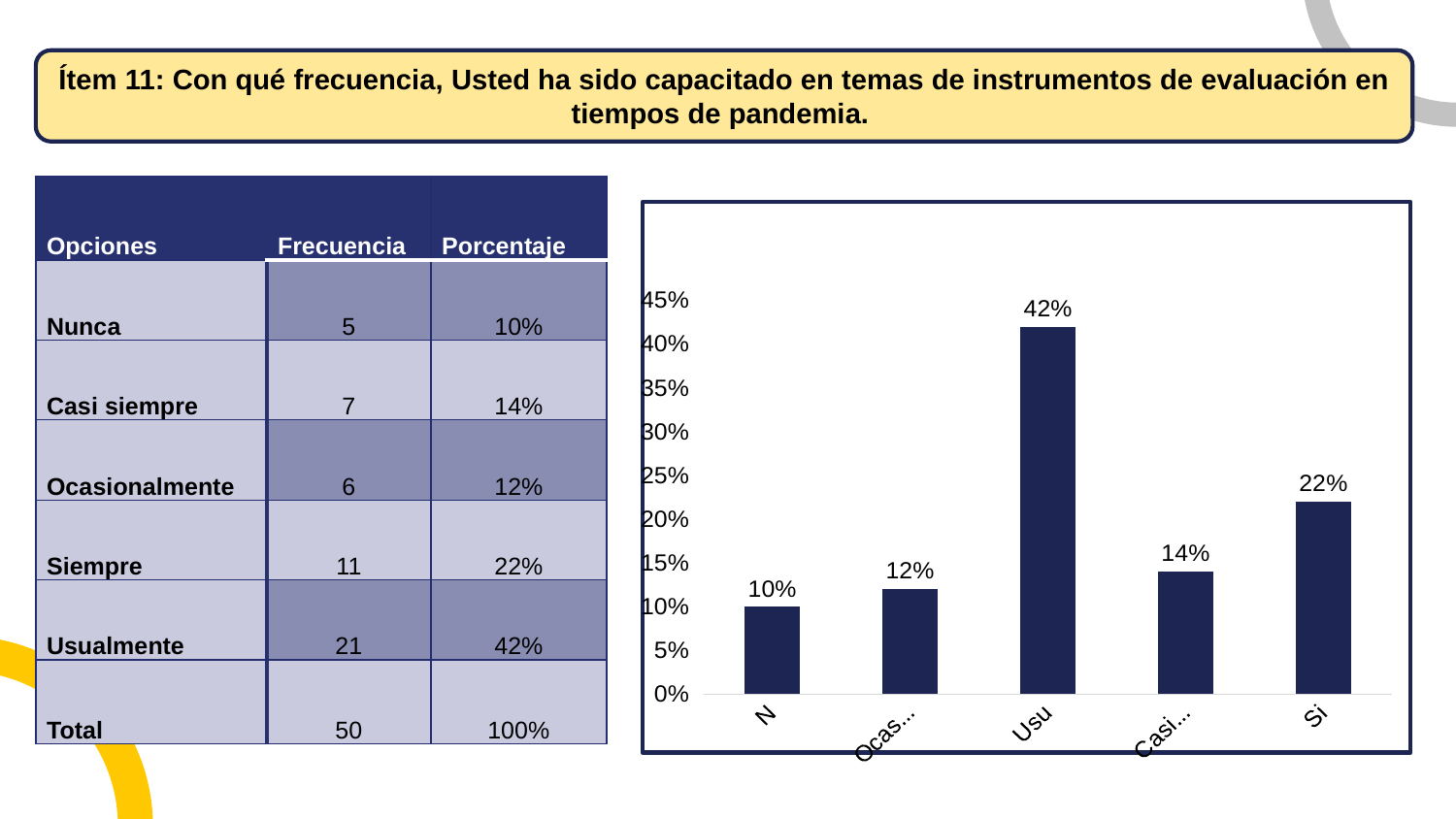
Which bar has the lowest value? N Which bar has the highest value? Usu What is the difference between the value of the "Usu" bar and the "Si" bar? 20% What is the value of the last bar (labelled "Si")? 22% Which is larger, the value of the "Ocas..." bar or the "Casi..." bar? Casi... What is the value of the bar labelled "Usu"? 42% How many bars are plotted in the chart? 5 What is the value of the bar labelled "Casi..."? 14% What type of chart is shown on the slide? bar chart What is the value of the first bar (labelled "N")? 10% What is the highest value shown on the vertical axis? 45% Is the value of the "Si" bar greater or less than 20%? greater